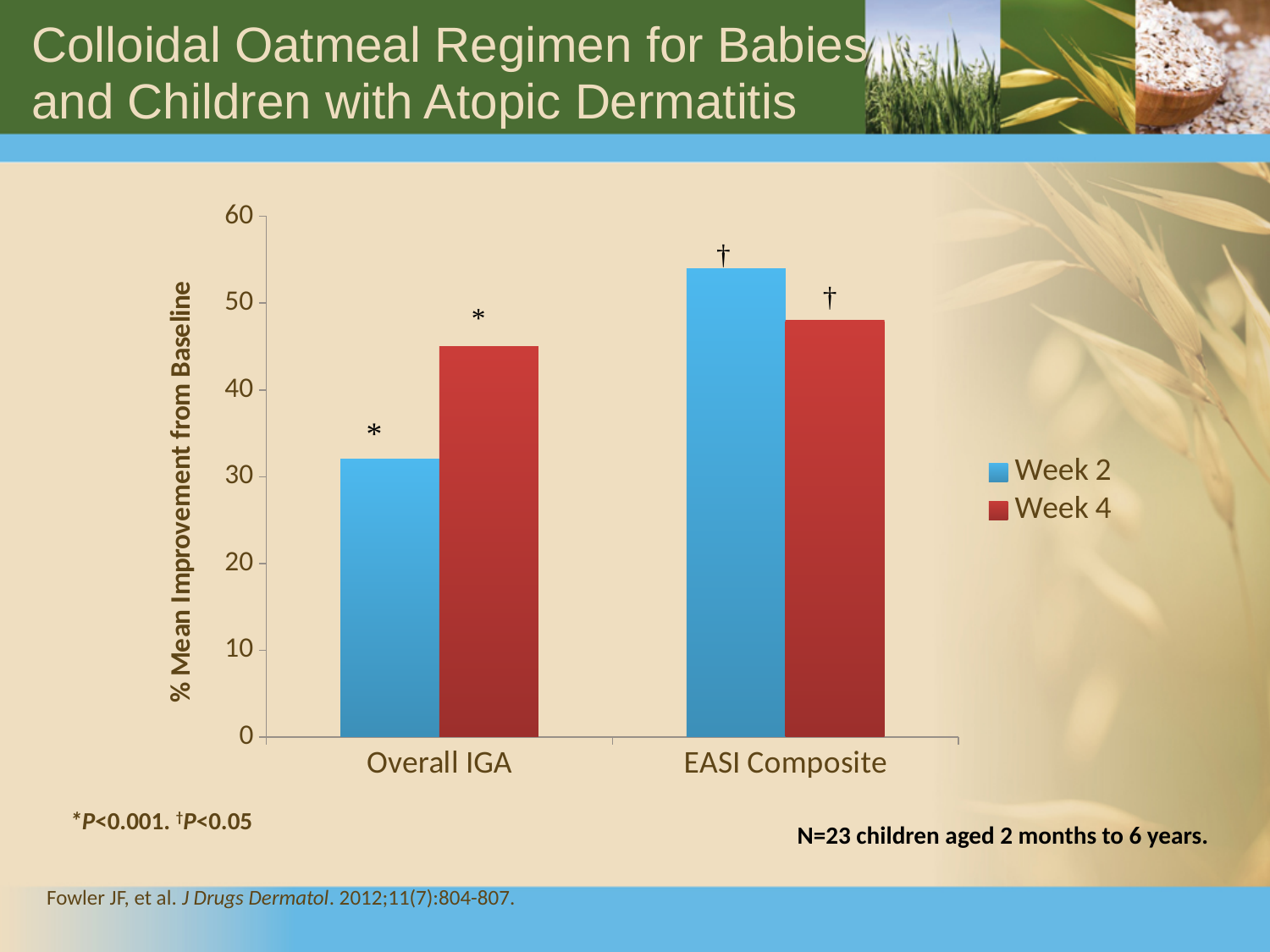
How many series does the legend list? 2 For Overall IGA, which is larger: the Week 2 value or the Week 4 value? Week 4 How many categories are shown on the x axis? 2 For EASI Composite, which is larger: the Week 2 value or the Week 4 value? Week 2 What kind of chart is shown on the slide? bar chart Is the Week 2 value for Overall IGA greater or less than 40? less Is the Week 2 value for Overall IGA greater or less than 30? greater What is the title of the y axis? % Mean Improvement from Baseline Which bar is the tallest in the chart? EASI Composite, Week 2 Is the Week 4 value for Overall IGA greater or less than 40? greater